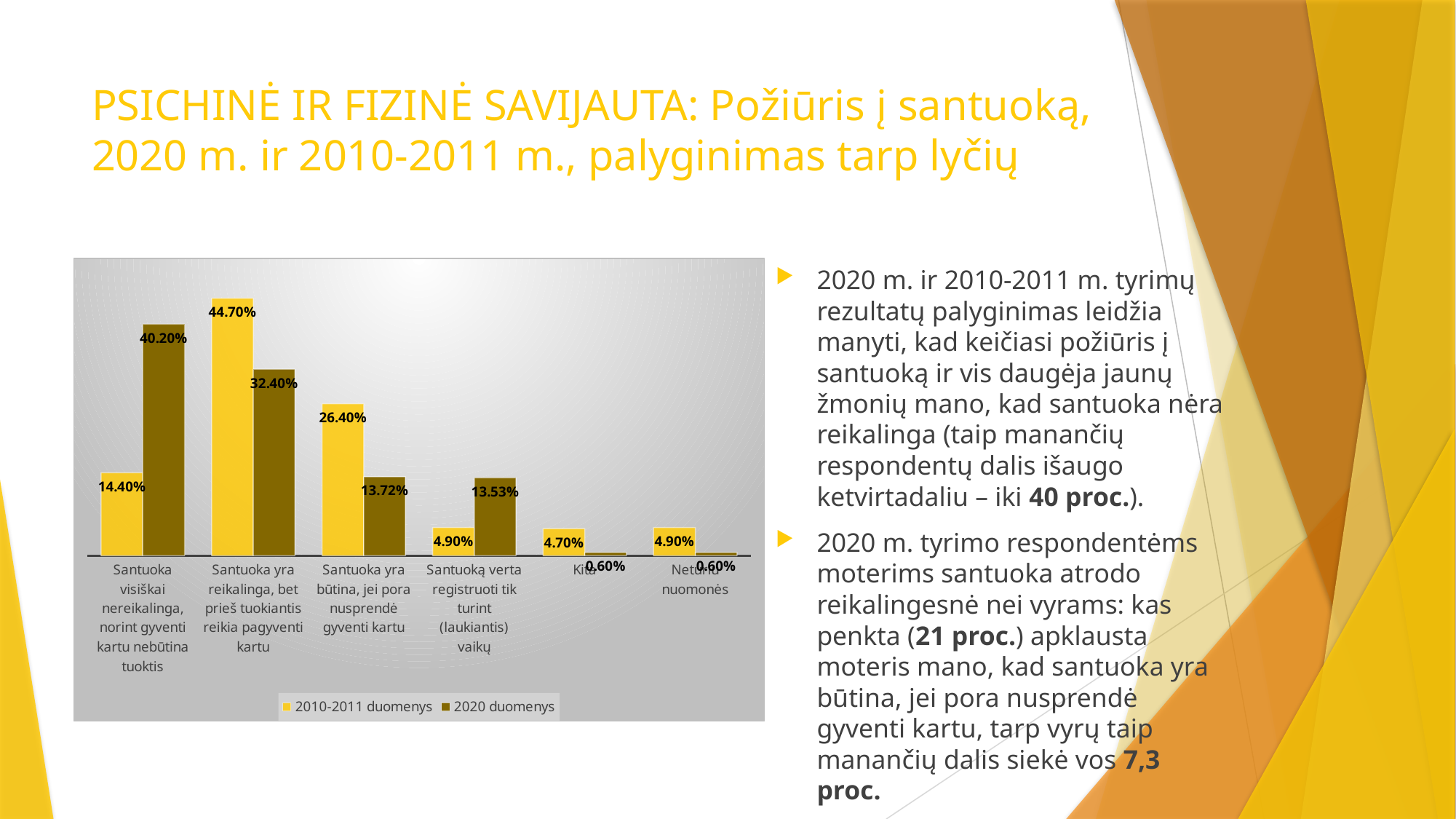
How many series does the chart legend list? 2 What is the 2010-2011 duomenys value for 'Santuoka yra reikalinga, bet prieš tuokiantis reikia pagyventi kartu'? 44.70% For 'Santuoka yra būtina, jei pora nusprendė gyventi kartu', which series has the larger value, 2010-2011 duomenys or 2020 duomenys? 2010-2011 duomenys What kind of chart is shown on the slide? bar chart What is the difference between the 2020 duomenys and 2010-2011 duomenys values for 'Santuoka visiškai nereikalinga, norint gyventi kartu nebūtina tuoktis'? 25.80% Which category has the highest 2010-2011 duomenys value? Santuoka yra reikalinga, bet prieš tuokiantis reikia pagyventi kartu Which series is shown in the darker brown colour in the chart? 2020 duomenys What is the 2020 duomenys value for 'Kita'? 0.60% Which category has the highest 2020 duomenys value? Santuoka visiškai nereikalinga, norint gyventi kartu nebūtina tuoktis How many categories are shown on the x axis of the chart? 6 What is the 2020 duomenys value for 'Santuoka visiškai nereikalinga, norint gyventi kartu nebūtina tuoktis'? 40.20% What is the 2020 duomenys value for 'Santuoką verta registruoti tik turint (laukiantis) vaikų'? 13.53%